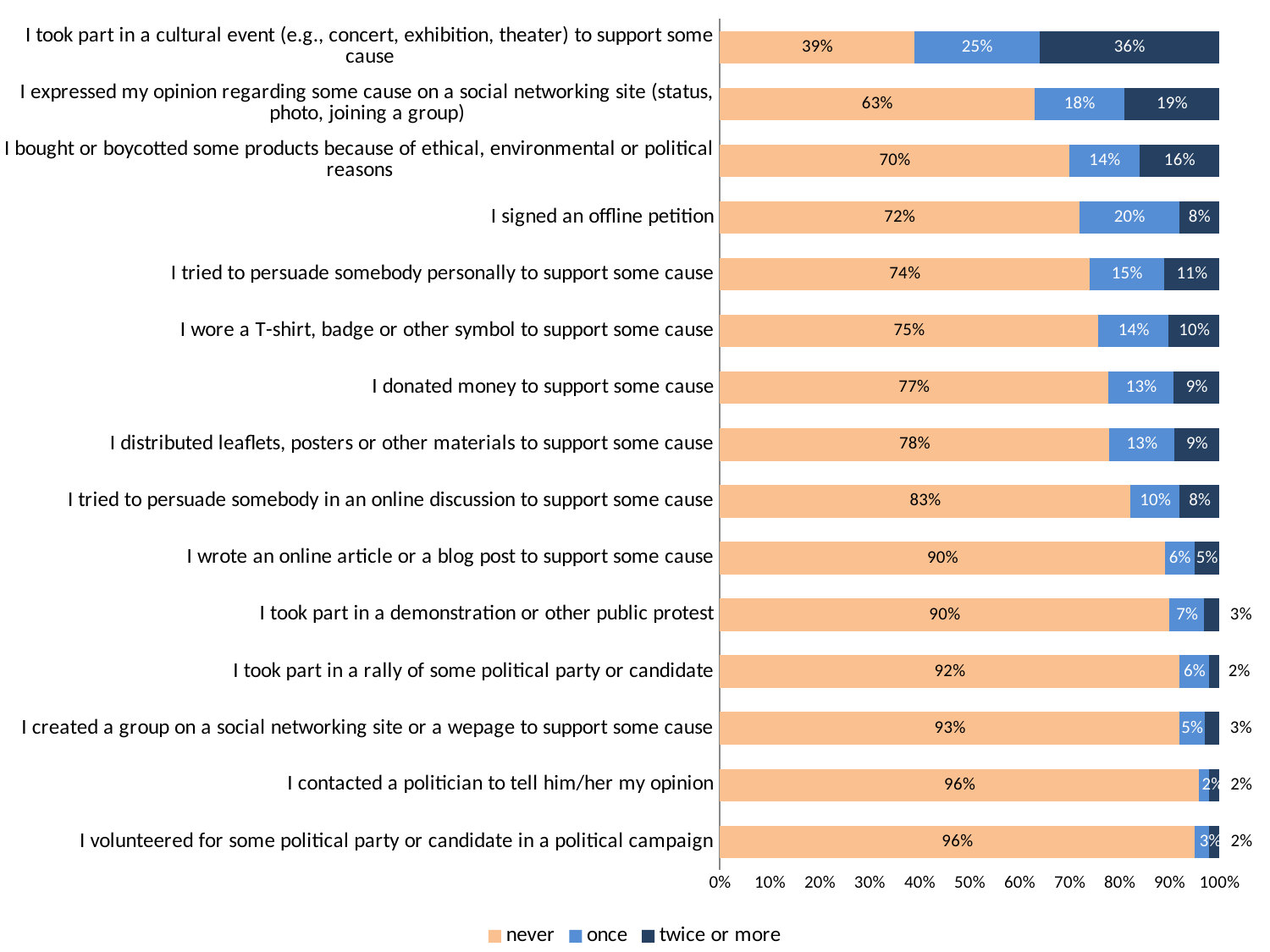
What is the 'once' value for 'I took part in a cultural event (e.g., concert, exhibition, theater) to support some cause'? 25% What is the 'never' value for 'I signed an offline petition'? 72% What is the total of the stacked bar for 'I took part in a cultural event (e.g., concert, exhibition, theater) to support some cause'? 100% How many series does the legend list? 3 Which is larger: the 'once' value for 'I signed an offline petition' or the 'once' value for 'I expressed my opinion regarding some cause on a social networking site (status, photo, joining a group)'? I signed an offline petition What are the three legend entries in the chart? never, once, twice or more What kind of chart is shown on the slide? stacked bar chart Which activity has the lowest 'never' value? I took part in a cultural event (e.g., concert, exhibition, theater) to support some cause How many categories (activities) are plotted in the chart? 15 What is the difference between the 'never' values for 'I donated money to support some cause' and 'I signed an offline petition'? 5% Which activity has the highest 'twice or more' value? I took part in a cultural event (e.g., concert, exhibition, theater) to support some cause What is the 'twice or more' value for 'I bought or boycotted some products because of ethical, environmental or political reasons'? 16%